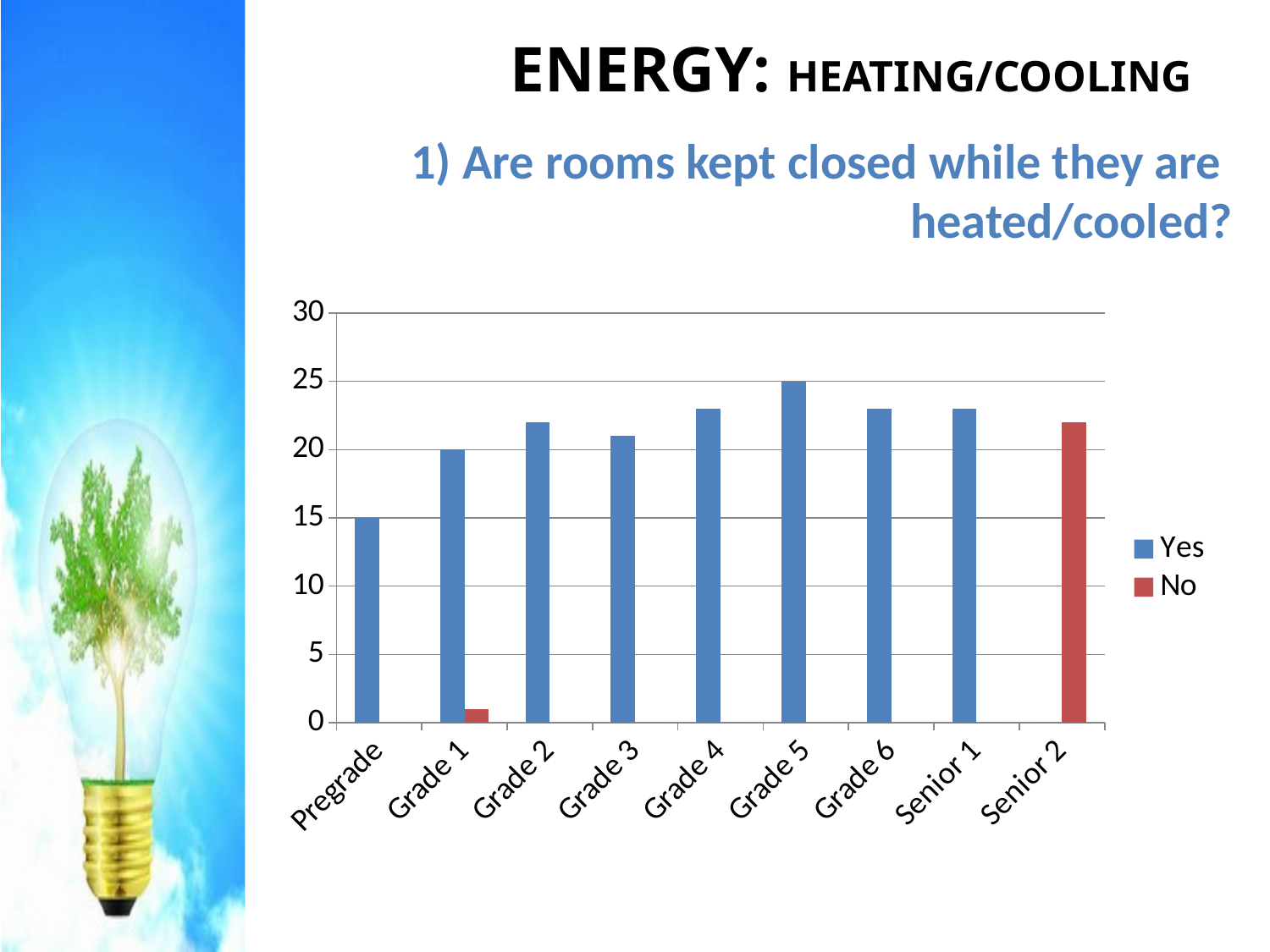
What is the Yes value for Pregrade? 15 Which category has the lowest Yes value? Senior 2 What is the Yes value for Grade 5? 25 How many series does the legend list? 2 Is the No value for Senior 2 greater or less than 20? greater What is the difference between the Yes values for Grade 5 and Pregrade? 10 What is the Yes value for Grade 1? 20 Which has a larger Yes value, Grade 1 or Pregrade? Grade 1 How many categories are shown on the x axis? 9 Is the No value for Grade 1 greater or less than 5? less What kind of chart is shown on the slide? Bar chart Which category has the highest Yes value? Grade 5